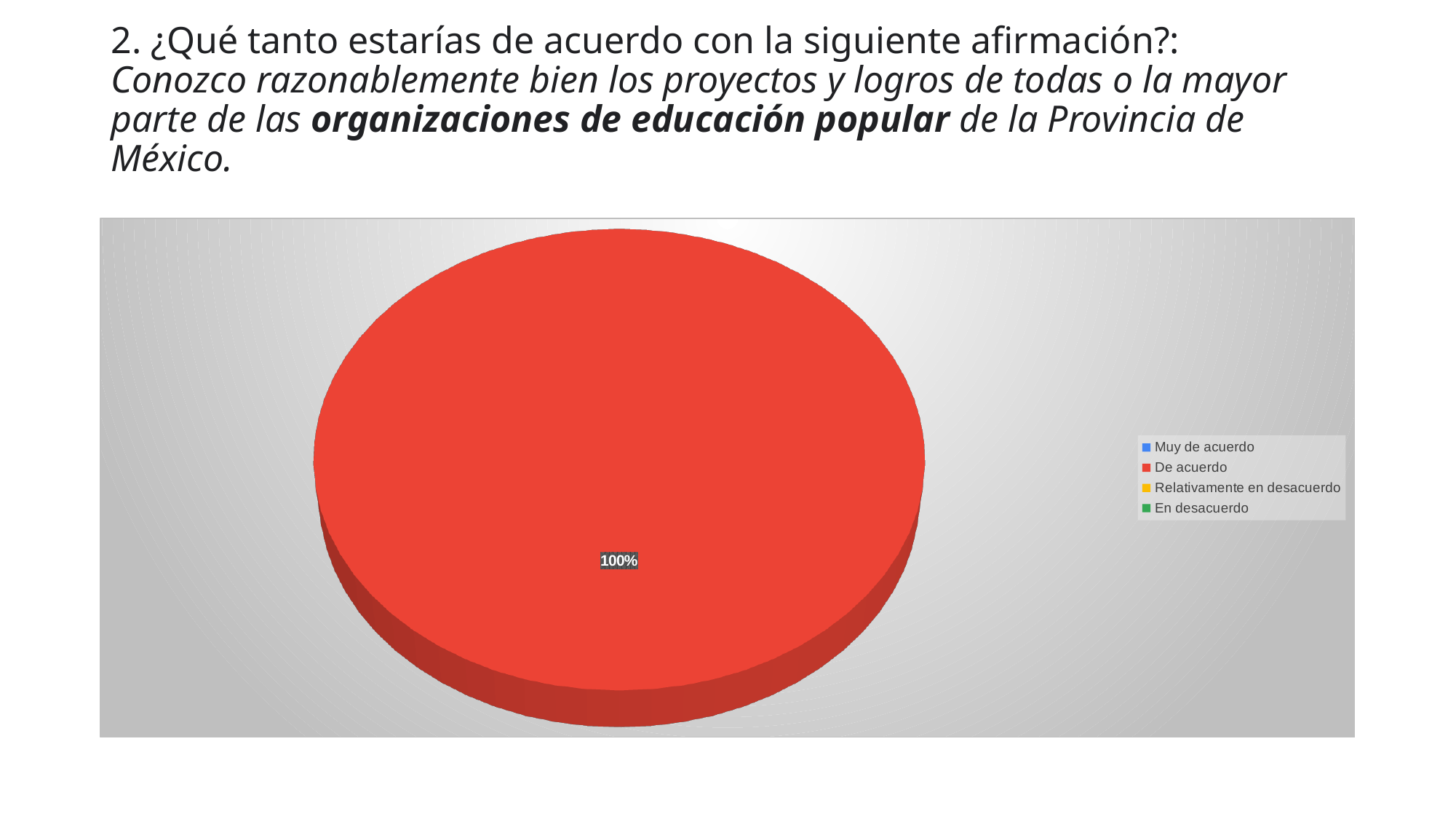
Is the share for 'De acuerdo' greater or less than 50%? greater What colour is the 'De acuerdo' slice? red Which legend entry is listed first? Muy de acuerdo What is the data label printed on the pie slice? 100% How many slices are visible in the pie chart? 1 What kind of chart is shown on the slide? pie chart How many entries does the legend list? 4 Which category has the largest share of the pie? De acuerdo What share of the pie does the 'De acuerdo' slice represent? 100%